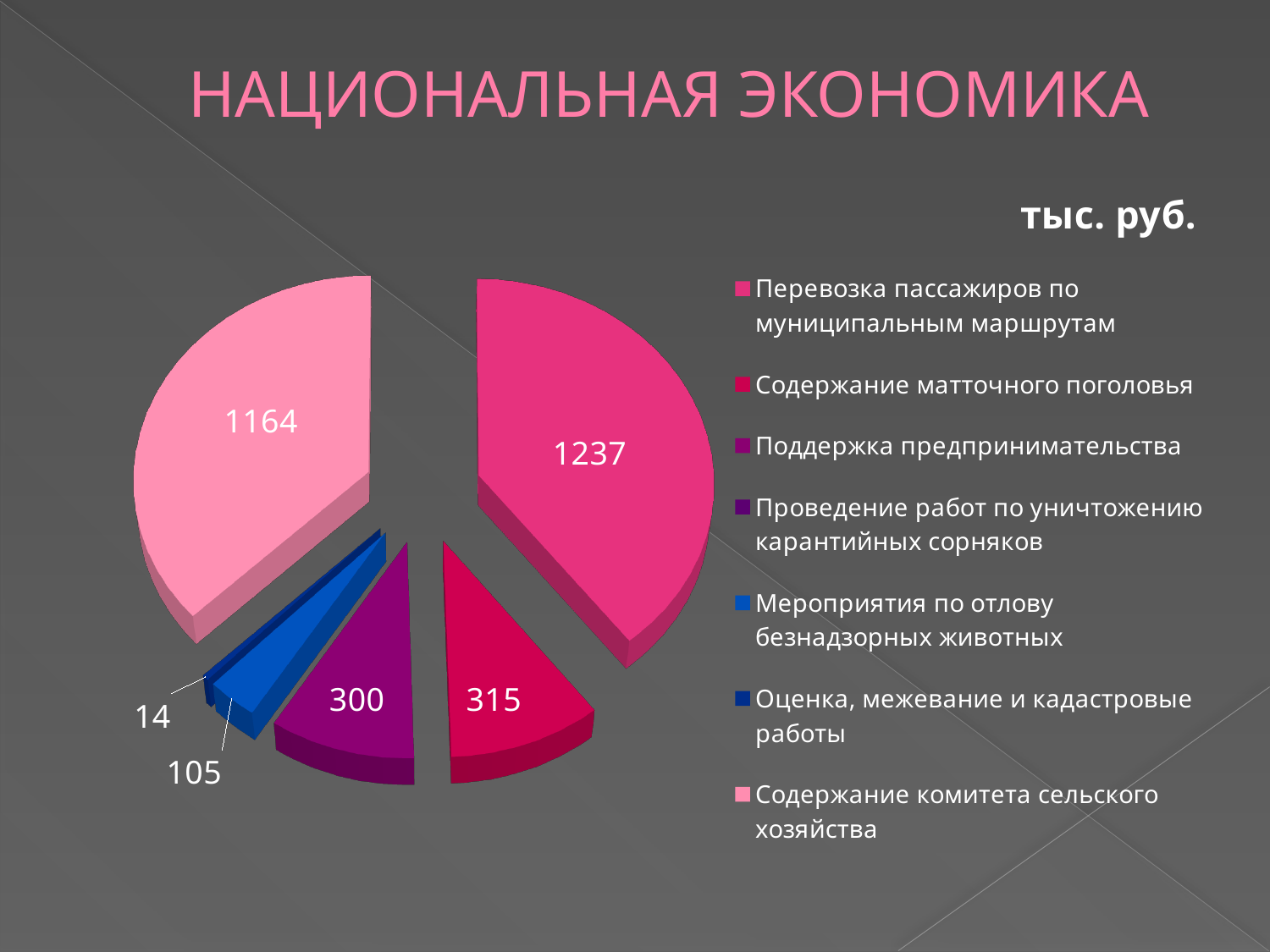
What is the value for Содержание матточного поголовья? 315 Which is larger: Перевозка пассажиров по муниципальным маршрутам or Содержание комитета сельского хозяйства? Перевозка пассажиров по муниципальным маршрутам What kind of chart is shown on the slide? Pie chart What is the value for Поддержка предпринимательства? 300 Which is larger: Содержание матточного поголовья or Поддержка предпринимательства? Содержание матточного поголовья What is the value for Содержание комитета сельского хозяйства? 1164 In what units are the chart values given, according to the slide? тыс. руб. Which category has the largest slice of the pie? Перевозка пассажиров по муниципальным маршрутам What is the difference between the values for Перевозка пассажиров по муниципальным маршрутам and Содержание комитета сельского хозяйства? 73 What is the value for Перевозка пассажиров по муниципальным маршрутам? 1237 How many categories does the legend list? 7 What is the difference between the values for Содержание матточного поголовья and Поддержка предпринимательства? 15